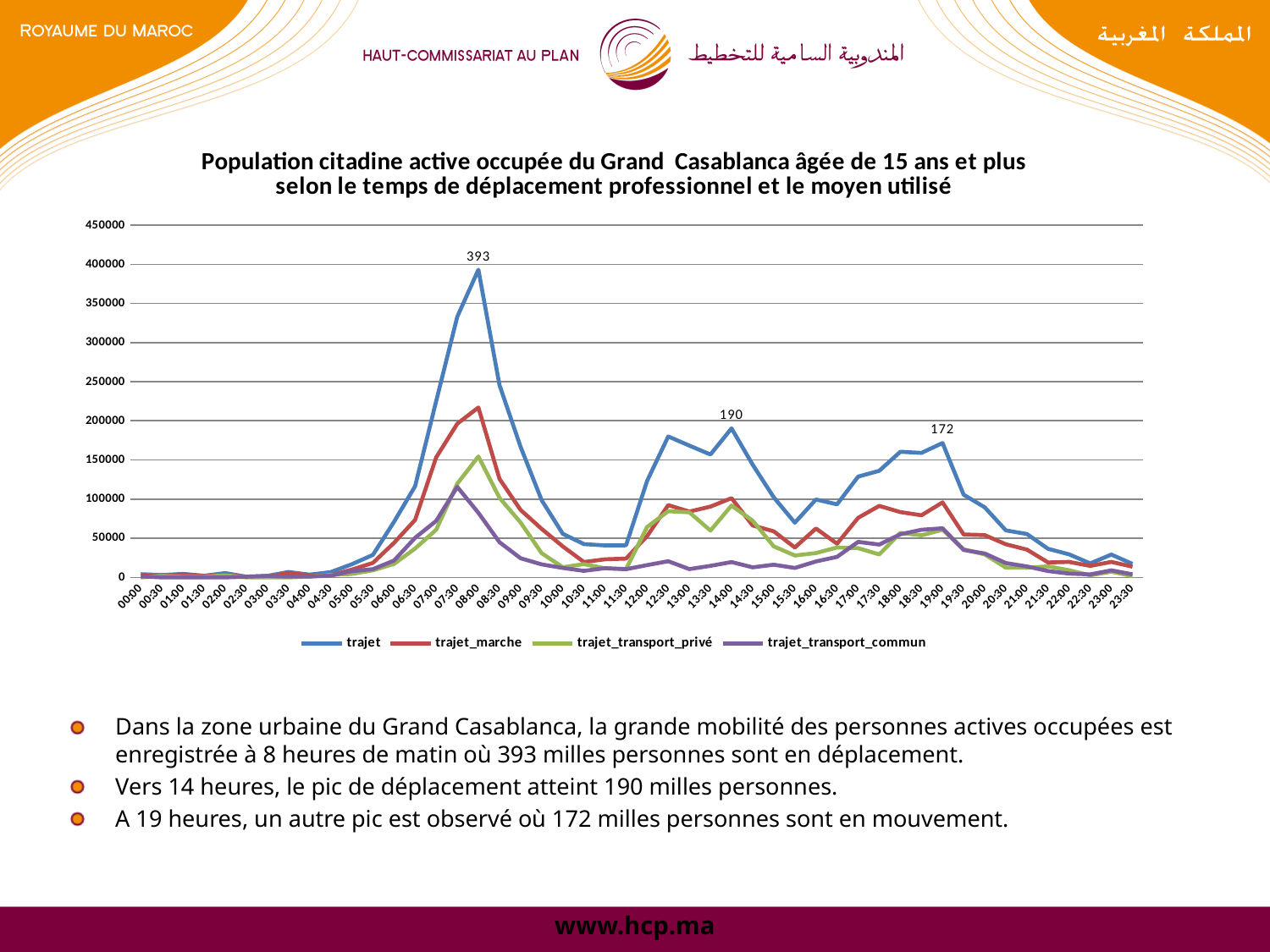
What value is labelled on the trajet line at 14:00? 190 What value is labelled on the trajet line at 19:00? 172 What colour is the trajet line in the legend? blue What value is labelled on the trajet line at 08:00? 393 At which time does the trajet line reach its highest value? 08:00 Is the value for trajet_transport_commun at 07:30 greater or less than 150000? less What kind of chart is shown on the slide? line chart At 08:00, which is larger: trajet_marche or trajet_transport_privé? trajet_marche Does the trajet line rise or fall between 08:00 and 10:00? fall What is the difference between the labelled values at 14:00 and 19:00 on the trajet line? 18 What is the difference between the labelled values at 08:00 and 14:00 on the trajet line? 203 How many series does the legend list? 4